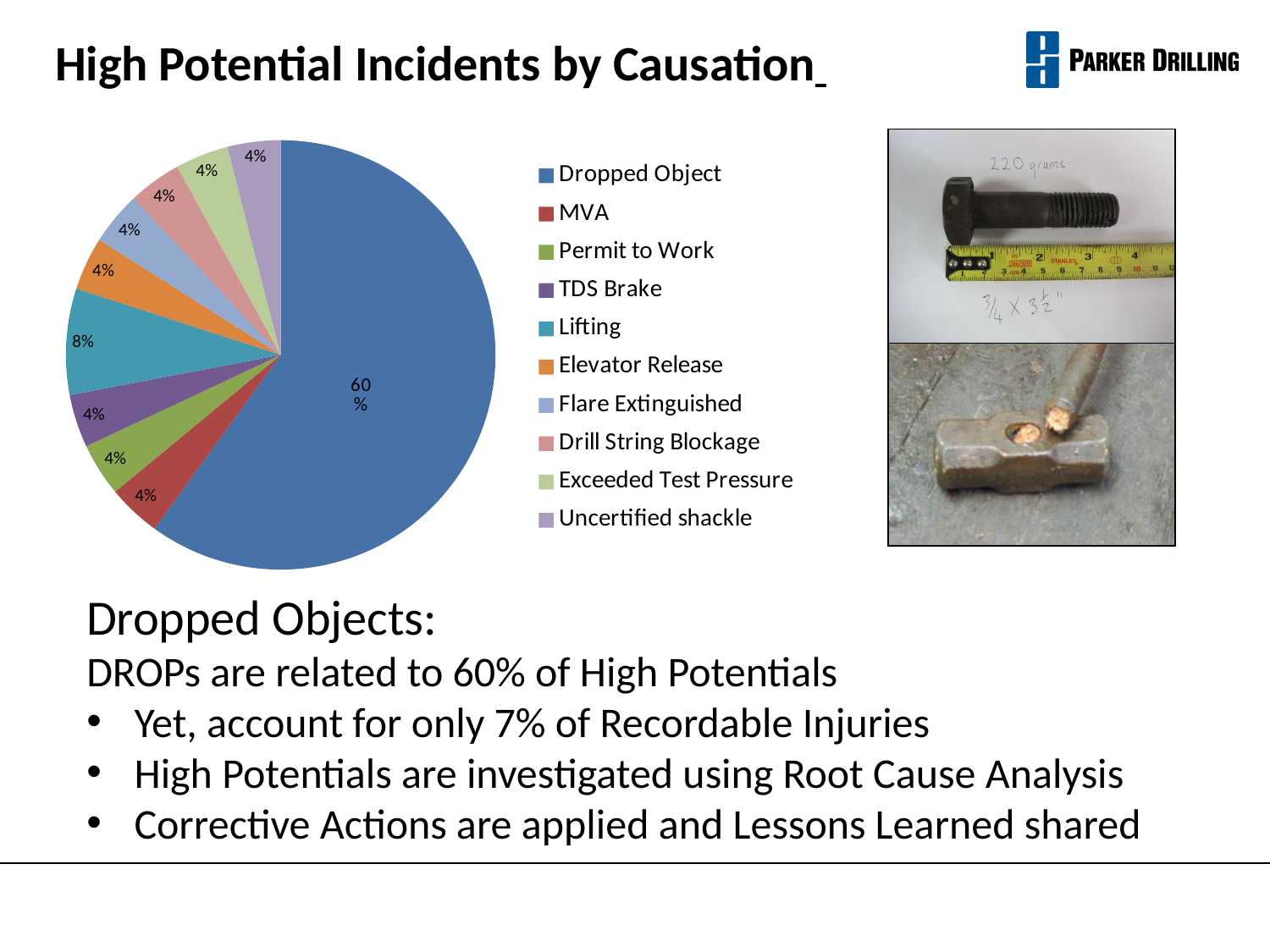
What is the title of the chart? High Potential Incidents by Causation Which is larger, the share for Lifting or the share for Elevator Release? Lifting What is the value shown for MVA? 4% What share of High Potential Incidents is attributed to Lifting? 8% What is the difference between the Lifting share and the TDS Brake share? 4% Which causation category has the largest slice of the pie? Dropped Object What share of High Potential Incidents is attributed to Dropped Object? 60% What is the value shown for Uncertified shackle? 4% How many causation categories does the legend list? 10 What kind of chart is shown on the slide? pie chart What is the difference between the Dropped Object share and the Lifting share? 52% Which legend entry is shown in orange? Elevator Release